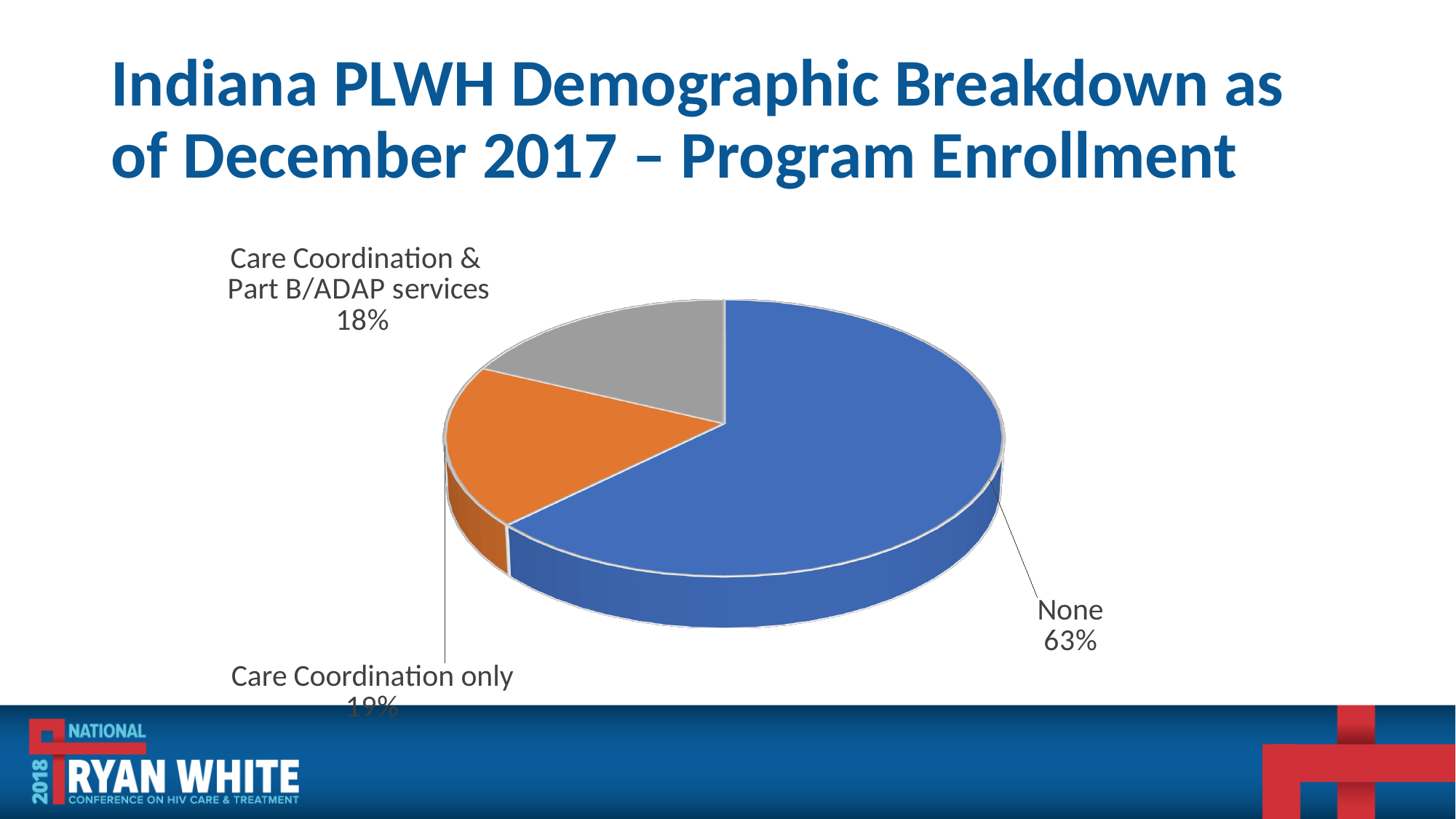
What kind of chart is shown on the slide? Pie chart What share of the pie does the "None" slice represent? 63% How many slices does the pie chart have? 3 Which category has the largest share of the pie? None Which is larger: the share for "None" or the share for "Care Coordination only"? None What colour is the "None" slice of the pie? Blue What percentage is shown for "Care Coordination & Part B/ADAP services"? 18% What is the difference in percentage points between "None" and "Care Coordination only"? 44 What is the difference in percentage points between "Care Coordination only" and "Care Coordination & Part B/ADAP services"? 1 Which category has the smallest share of the pie? Care Coordination & Part B/ADAP services What is the title of the slide containing the pie chart? Indiana PLWH Demographic Breakdown as of December 2017 – Program Enrollment What percentage is shown for "Care Coordination only"? 19%